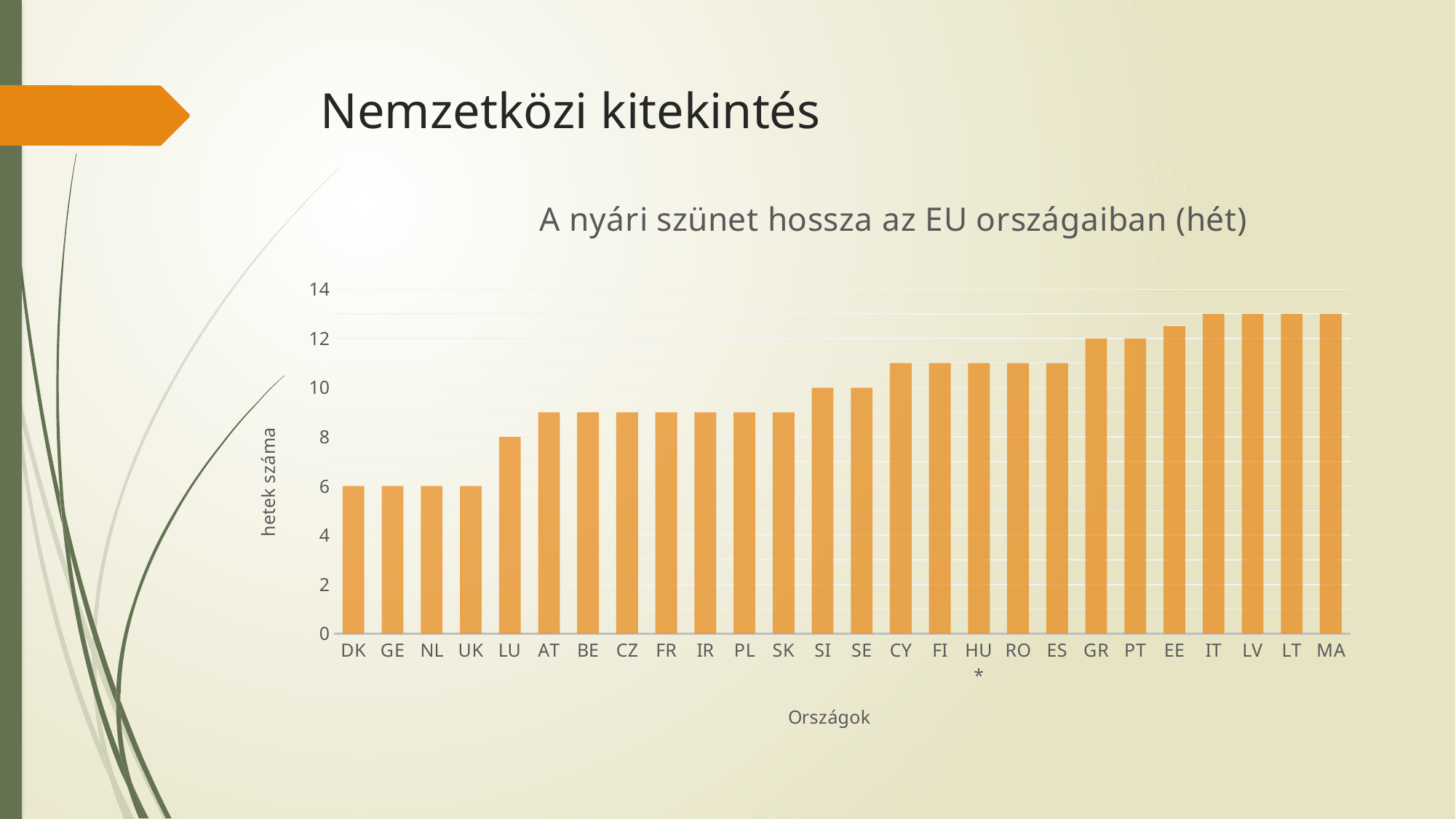
What is the value for LU? 8 Do the values generally rise or fall from left to right along the x axis? rise What is the value for DK? 6 What is the value for GR? 12 Which is larger, the value for LU or the value for UK? LU Is the value for AT greater or less than 8? greater Is the value for IT greater or less than 12? greater What is the difference between the values for SE and NL? 4 What is the title of the chart? A nyári szünet hossza az EU országaiban (hét) What kind of chart is shown on the slide? bar chart How many countries are shown on the x axis of the chart? 26 What is the value for SI? 10